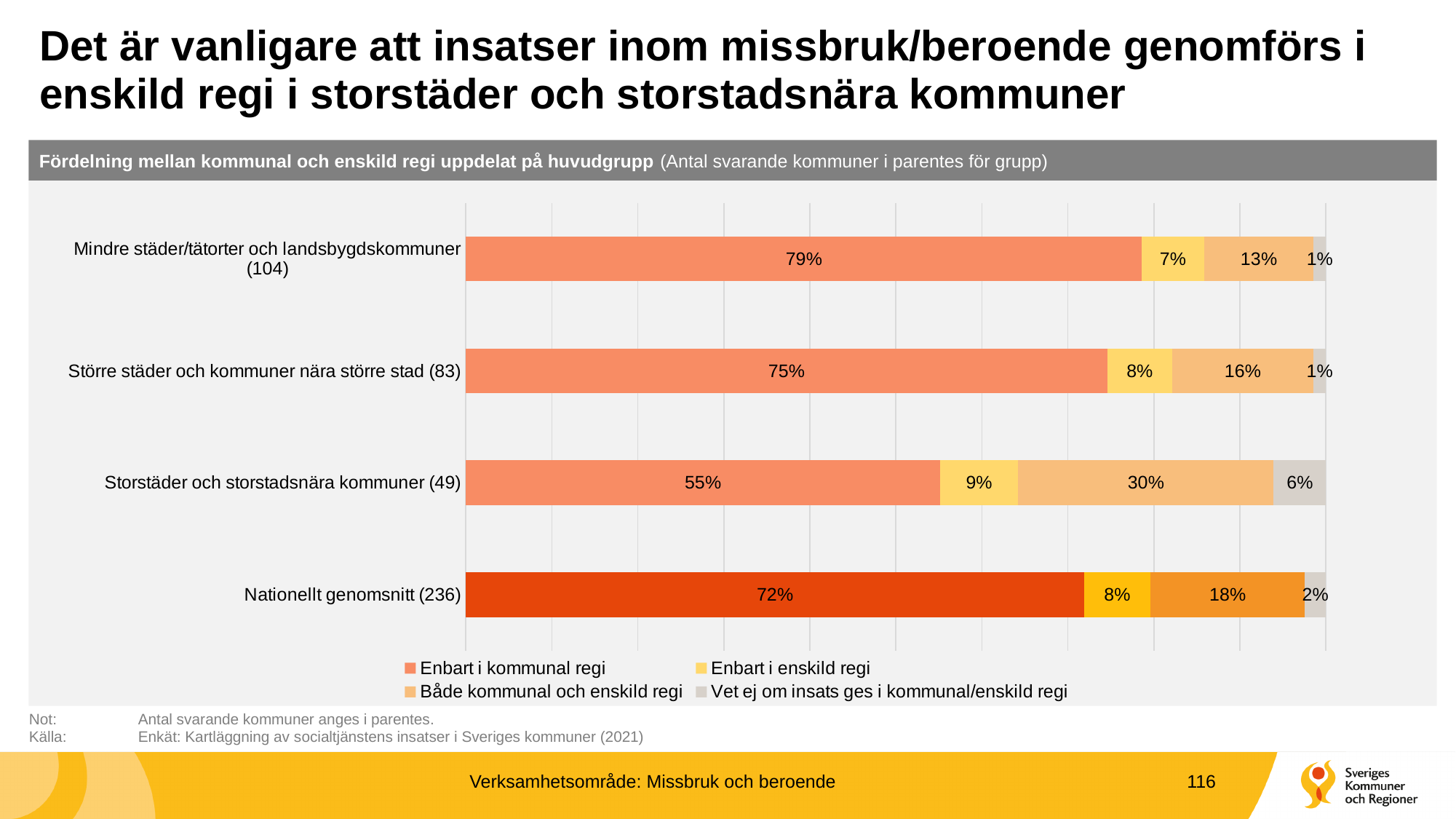
What is the difference between the 'Både kommunal och enskild regi' values for Storstäder och storstadsnära kommuner (49) and Nationellt genomsnitt (236)? 12% What is the total of the stacked bar for Större städer och kommuner nära större stad (83)? 100% Which legend entry is shown in the lightest grey colour? Vet ej om insats ges i kommunal/enskild regi How many categories (groups) are plotted on the chart? 4 What kind of chart is shown on the slide? Stacked bar chart What is the value for 'Vet ej om insats ges i kommunal/enskild regi' for Nationellt genomsnitt (236)? 2% Which is larger: the 'Enbart i enskild regi' value for Storstäder och storstadsnära kommuner (49) or for Mindre städer/tätorter och landsbygdskommuner (104)? Storstäder och storstadsnära kommuner (49) How many series does the legend list? 4 What is the value for 'Enbart i kommunal regi' for Storstäder och storstadsnära kommuner (49)? 55% What is the value for 'Både kommunal och enskild regi' for Större städer och kommuner nära större stad (83)? 16% Which group has the highest value for 'Enbart i kommunal regi'? Mindre städer/tätorter och landsbygdskommuner (104) Which group has the lowest value for 'Både kommunal och enskild regi'? Mindre städer/tätorter och landsbygdskommuner (104)